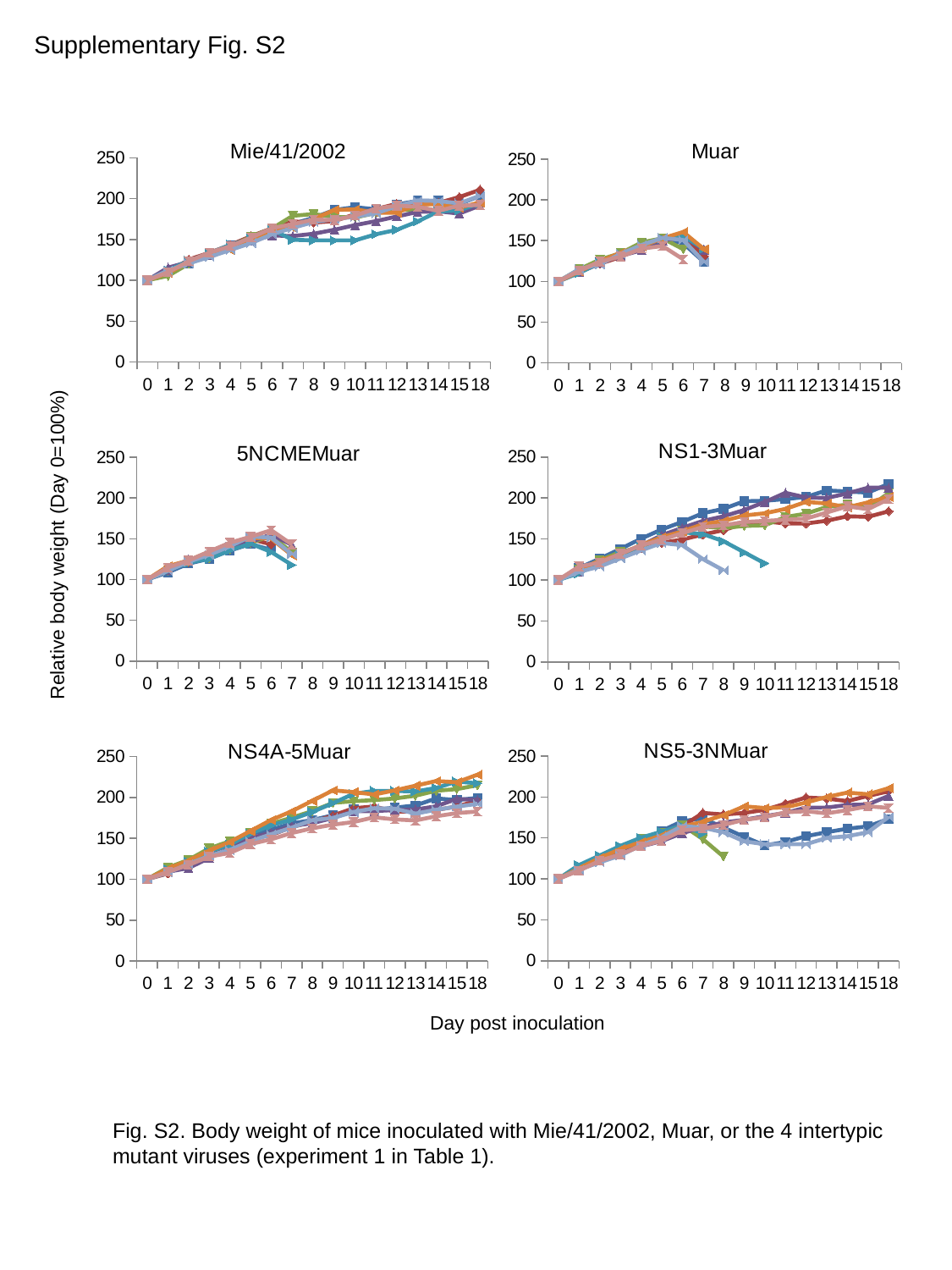
What kind of charts are shown on the slide? Line charts In the NS4A-5Muar chart, are the values at day 18 greater or less than 150? greater What is the title of the chart in the top-left position? Mie/41/2002 In the Mie/41/2002 chart, are the values at day 18 greater or less than 150? greater What is the label of the shared y axis? Relative body weight (Day 0=100%) In the Mie/41/2002 chart, what is the relative body weight value at day 0? 100 In the Muar chart, are the values at day 7 greater or less than 150? less In the NS4A-5Muar chart, do the values generally rise or fall from day 0 to day 9? rise In the Muar chart, do the values rise or fall between day 5 and day 7? fall What is the highest value shown on the y axis of the NS5-3NMuar chart? 250 How many charts are on the slide? 6